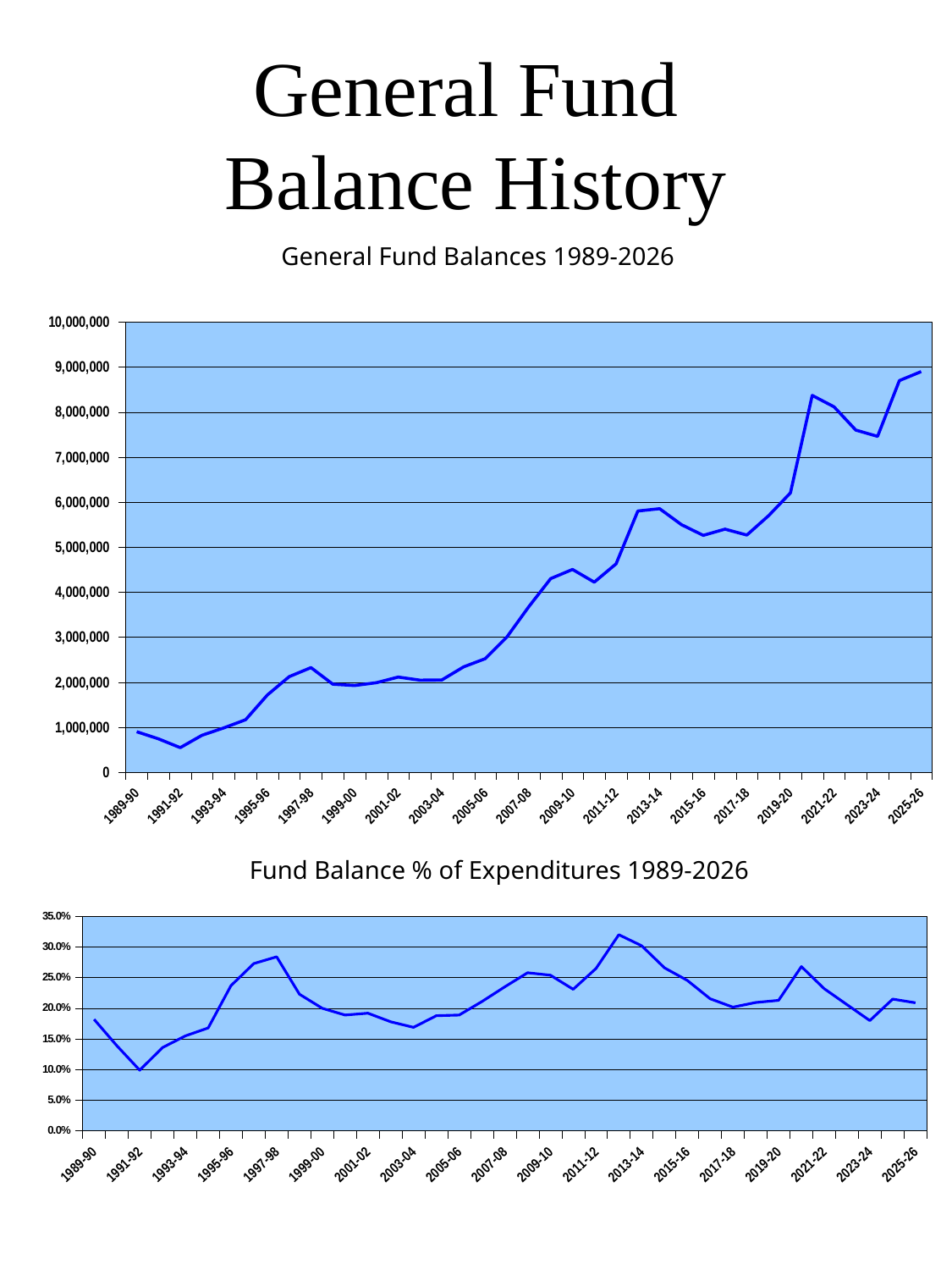
In the 'General Fund Balances 1989-2026' chart, is the value for 2005-06 greater or less than 3,000,000? less In the 'General Fund Balances 1989-2026' chart, is the value for 2023-24 greater or less than 8,000,000? less In the 'General Fund Balances 1989-2026' chart, which year has the highest fund balance? 2025-26 In the 'Fund Balance % of Expenditures 1989-2026' chart, is the value for 2003-04 greater or less than 20.0%? less In the 'General Fund Balances 1989-2026' chart, does the fund balance generally rise or fall from 1989-90 to 2025-26? rise In the 'Fund Balance % of Expenditures 1989-2026' chart, which year has the highest value? 2012-13 In the 'General Fund Balances 1989-2026' chart, which year has the lowest fund balance? 1991-92 In the 'Fund Balance % of Expenditures 1989-2026' chart, which year has the lowest value? 1991-92 In the 'General Fund Balances 1989-2026' chart, which is larger, the value for 2013-14 or the value for 2009-10? 2013-14 What kind of chart is the 'General Fund Balances 1989-2026' chart? line chart